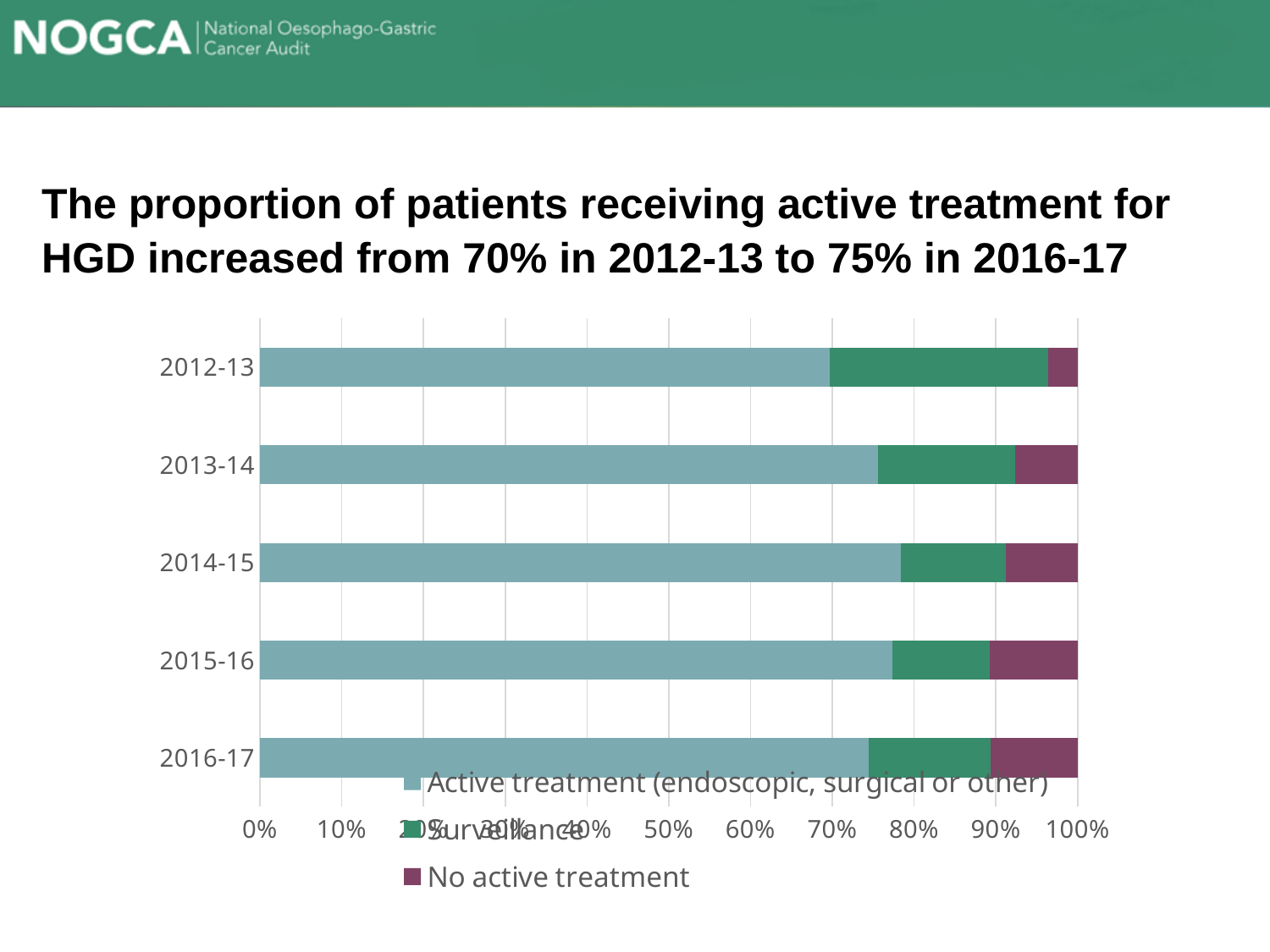
Which year has the smallest share of patients receiving active treatment? 2012-13 Which legend entry is shown in the dark purple colour? No active treatment What is the total of each stacked bar on the chart? 100% How many series does the legend list? 3 Is the no active treatment share for 2012-13 greater or less than 10%? less What is the first series listed in the legend? Active treatment (endoscopic, surgical or other) What kind of chart is shown on the slide? Stacked bar chart Which year has the smallest share of patients receiving no active treatment? 2012-13 How many years (categories) are plotted on the chart? 5 Is the active treatment share for 2012-13 greater or less than 60%? greater Is the active treatment share for 2014-15 greater or less than 70%? greater Which year has the larger active treatment share, 2012-13 or 2016-17? 2016-17